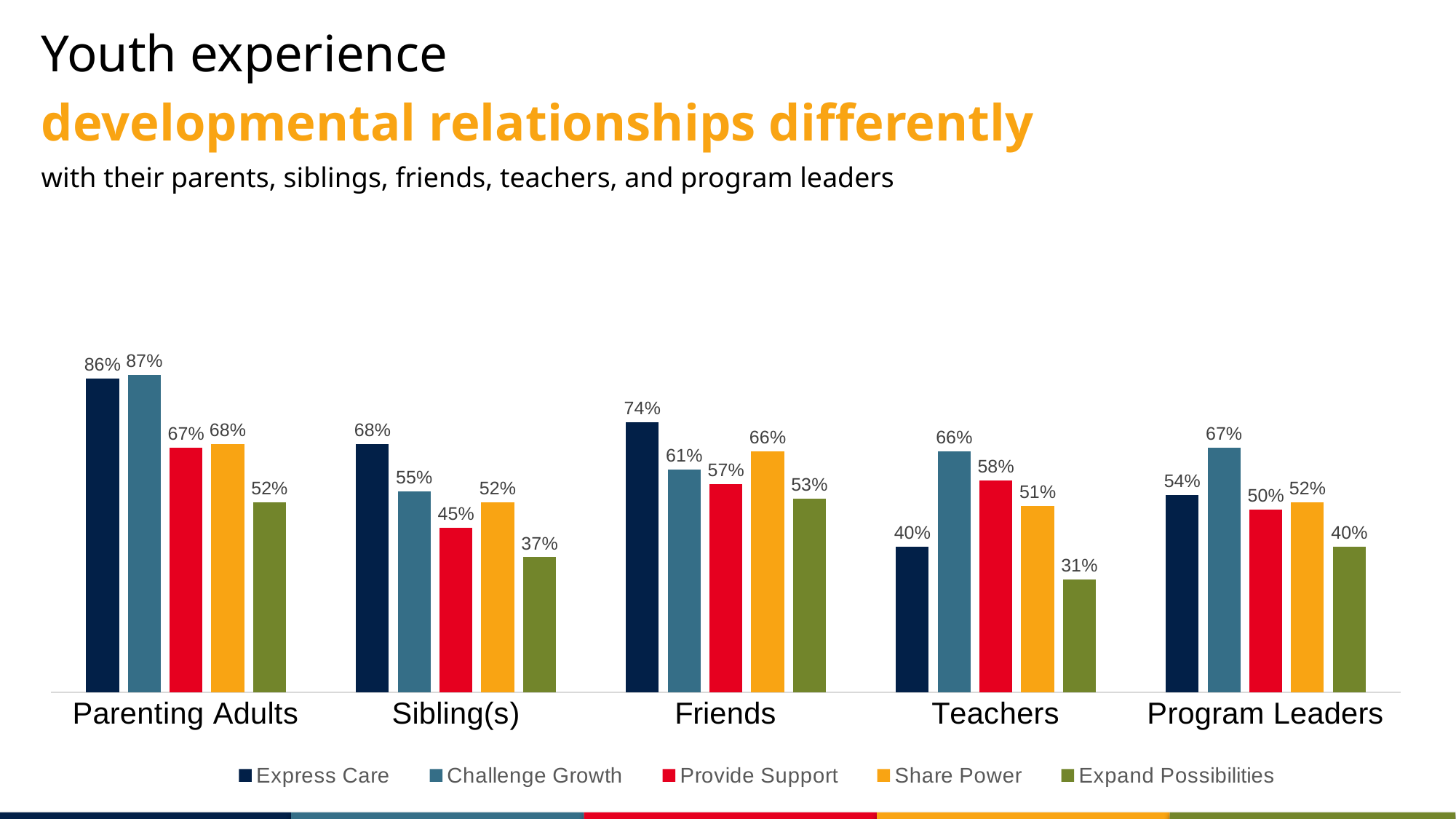
Which series is shown in red in the legend? Provide Support Which category has the highest Express Care value? Parenting Adults Which category has the lowest Expand Possibilities value? Teachers What is the Provide Support value for Program Leaders? 50% What is the difference between the Challenge Growth values for Parenting Adults and Sibling(s)? 32% How many series does the legend list? 5 What kind of chart is shown on the slide? Bar chart How many categories are shown on the x axis? 5 What is the Express Care value for Parenting Adults? 86% Which is larger for Teachers: Express Care or Challenge Growth? Challenge Growth What is the Expand Possibilities value for Teachers? 31% What is the Share Power value for Friends? 66%